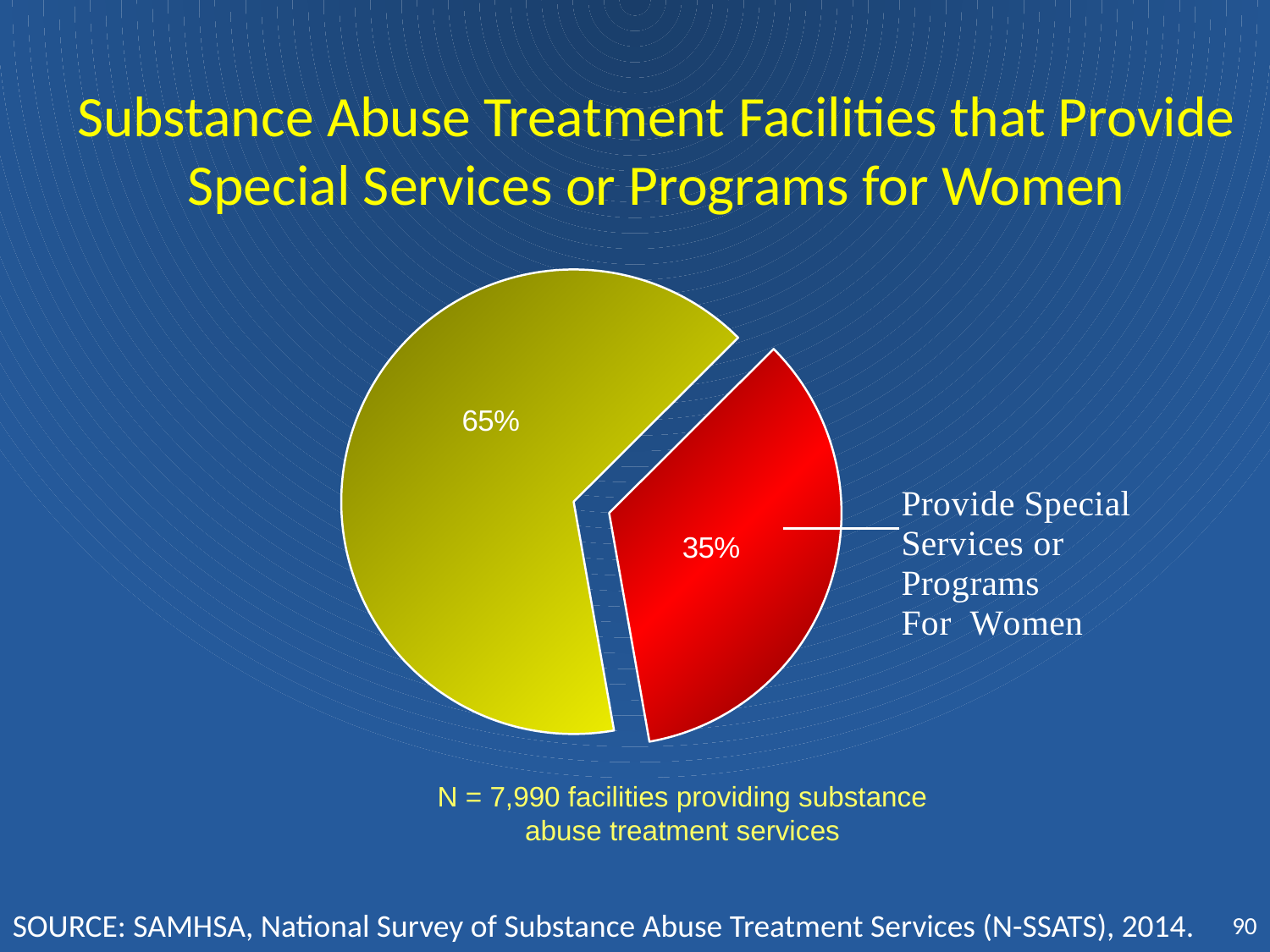
What colour is the slice labelled 'Provide Special Services or Programs For Women'? red What percentage of facilities provide special services or programs for women? 35% What is the difference in percentage points between the two slices of the pie? 30 What is the title of the chart on the slide? Substance Abuse Treatment Facilities that Provide Special Services or Programs for Women How many slices does the pie chart have? 2 What is the share of the pie labelled 'Provide Special Services or Programs For Women'? 35% What percentage is shown on the yellow slice of the pie? 65% Is the share of facilities that provide special services or programs for women greater or less than 50%? less Which slice of the pie is larger, the yellow slice or the red slice? yellow slice What kind of chart is shown on the slide? pie chart What is the total of the two percentages shown on the pie chart? 100%